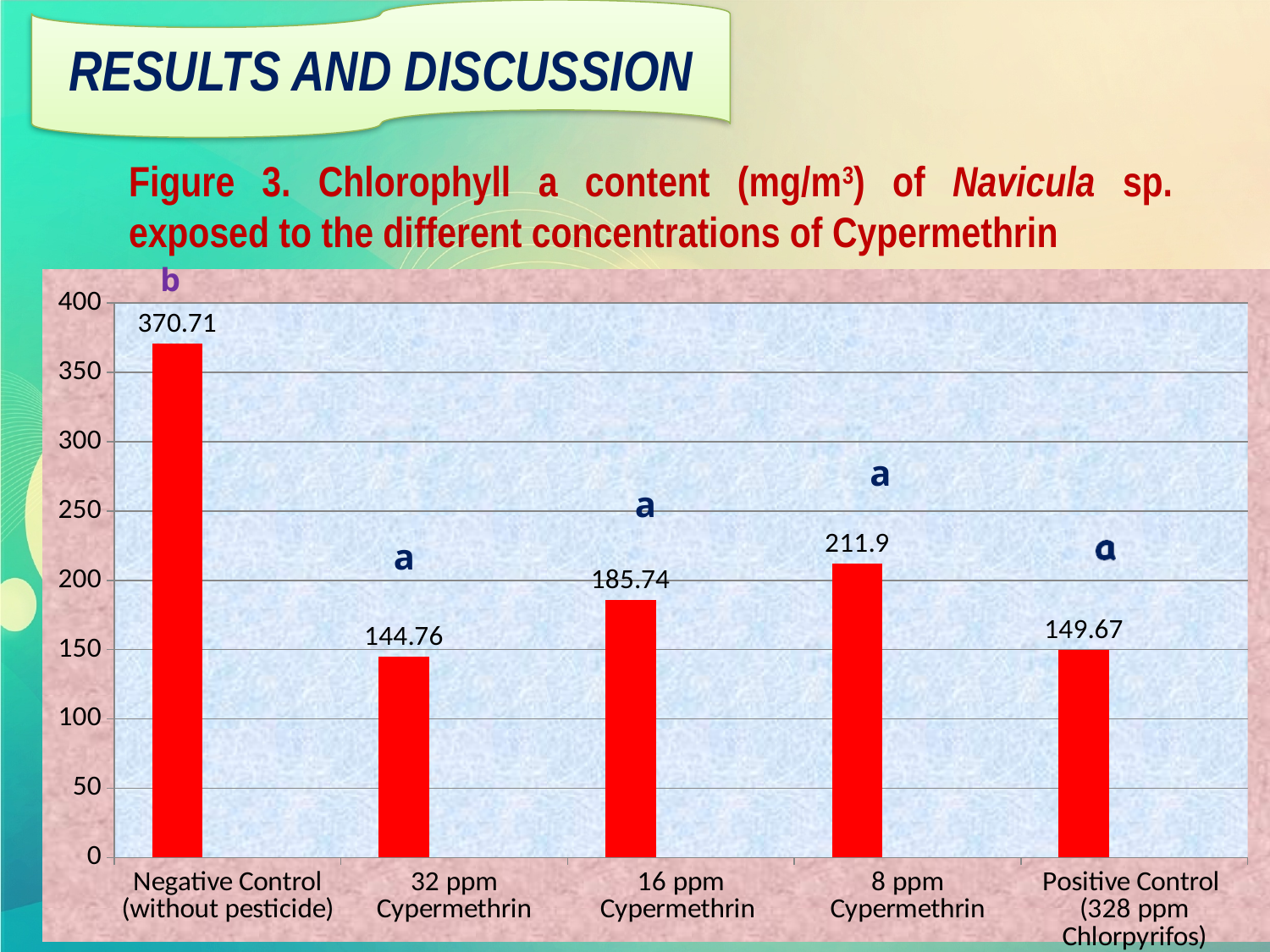
What is the value shown for the Positive Control (328 ppm Chlorpyrifos)? 149.67 What is the chlorophyll a content for the Negative Control (without pesticide)? 370.71 What is the value shown for 16 ppm Cypermethrin? 185.74 Which is larger, the value for 16 ppm Cypermethrin or the value for 8 ppm Cypermethrin? 8 ppm Cypermethrin What is the value shown for 8 ppm Cypermethrin? 211.9 What is the difference between the Negative Control value and the 8 ppm Cypermethrin value? 158.81 What kind of chart is shown on the slide? bar chart What is the value shown for 32 ppm Cypermethrin? 144.76 Is the value for 16 ppm Cypermethrin greater or less than 200? less How many categories are shown on the x axis? 5 Which category has the lowest chlorophyll a content? 32 ppm Cypermethrin Which category has the highest chlorophyll a content? Negative Control (without pesticide)